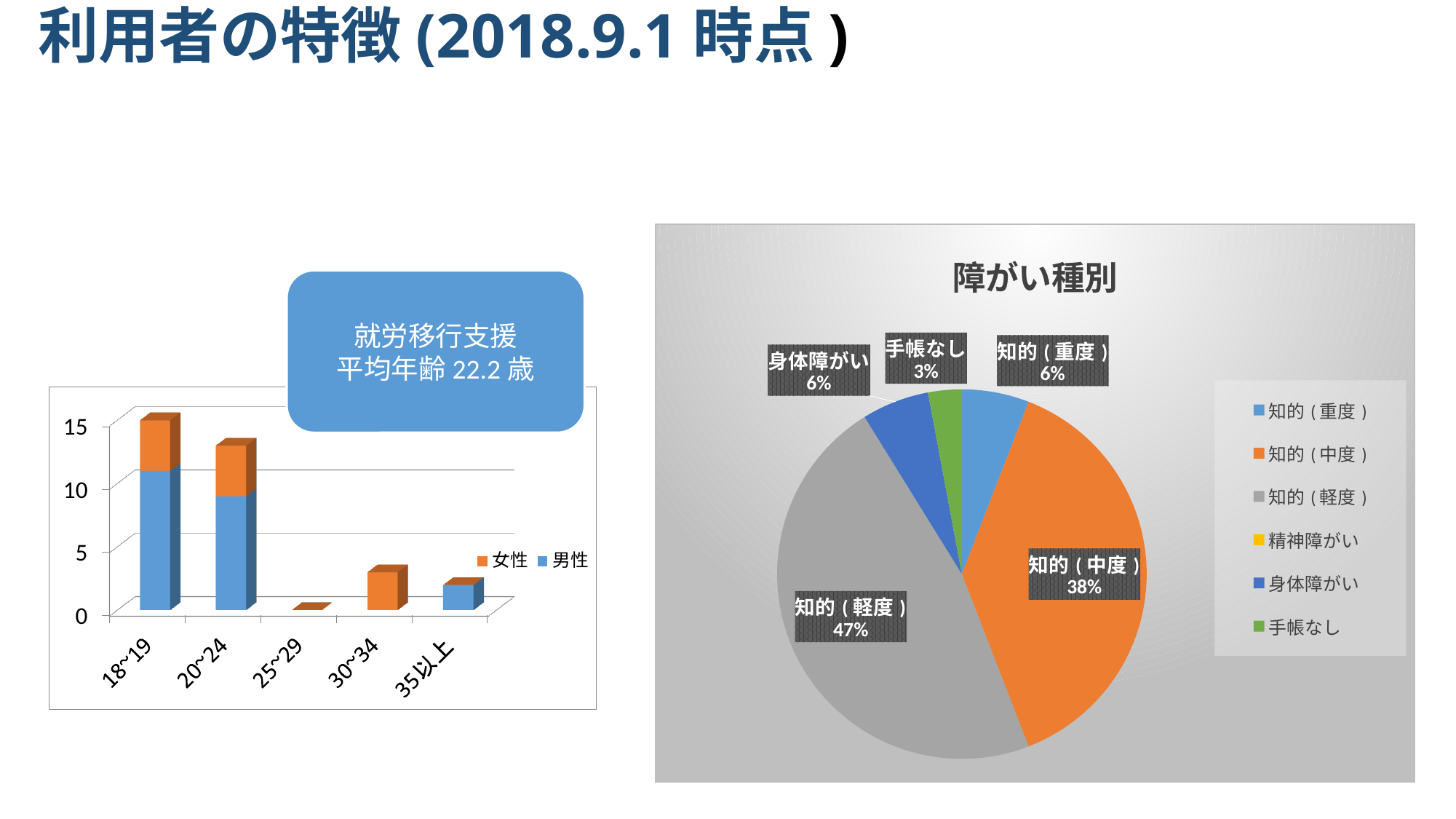
What kind of chart is the chart on the right side of the slide? Pie chart On the pie chart titled 障がい種別, which is larger, 知的(中度) or 身体障がい? 知的(中度) On the pie chart titled 障がい種別, what share does 手帳なし have? 3% What kind of chart is the chart on the left side of the slide? Bar chart On the pie chart titled 障がい種別, what is the difference in percentage points between 知的(軽度) and 知的(中度)? 9 percentage points On the bar chart on the left, is the total bar height for 18~19 greater or less than 10? greater On the bar chart on the left, which age category has the tallest bar? 18~19 On the pie chart titled 障がい種別, what share does 知的(軽度) have? 47% On the pie chart titled 障がい種別, which category has the largest slice? 知的(軽度) On the bar chart on the left, how many age categories are shown on the x axis? 5 On the pie chart titled 障がい種別, what share does 知的(中度) have? 38% On the pie chart titled 障がい種別, how many entries does the legend list? 6